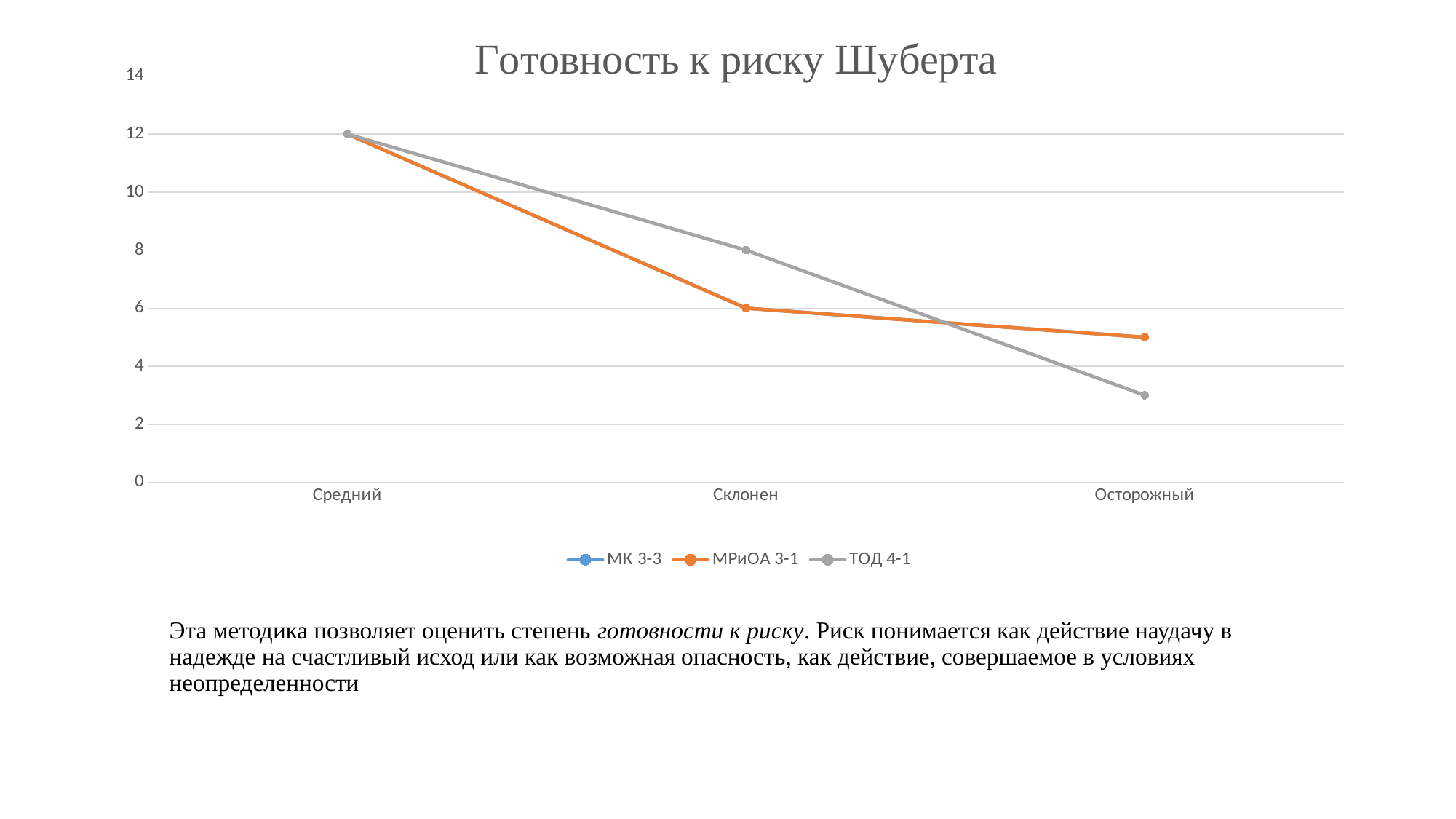
Do the values for ТОД 4-1 rise or fall from Средний to Осторожный? fall What is the value for ТОД 4-1 at Склонен? 8 What is the difference between ТОД 4-1 and МРиОА 3-1 at Склонен? 2 At Осторожный, which series has the larger value, МРиОА 3-1 or ТОД 4-1? МРиОА 3-1 At Склонен, which series has the larger value, МРиОА 3-1 or ТОД 4-1? ТОД 4-1 How many categories are shown on the x axis? 3 Is the value for ТОД 4-1 at Осторожный greater or less than 4? less What is the value for МРиОА 3-1 at Склонен? 6 What kind of chart is shown on the slide? line chart How many series does the legend list? 3 What is the value for ТОД 4-1 at Средний? 12 What is the title of the chart? Готовность к риску Шуберта